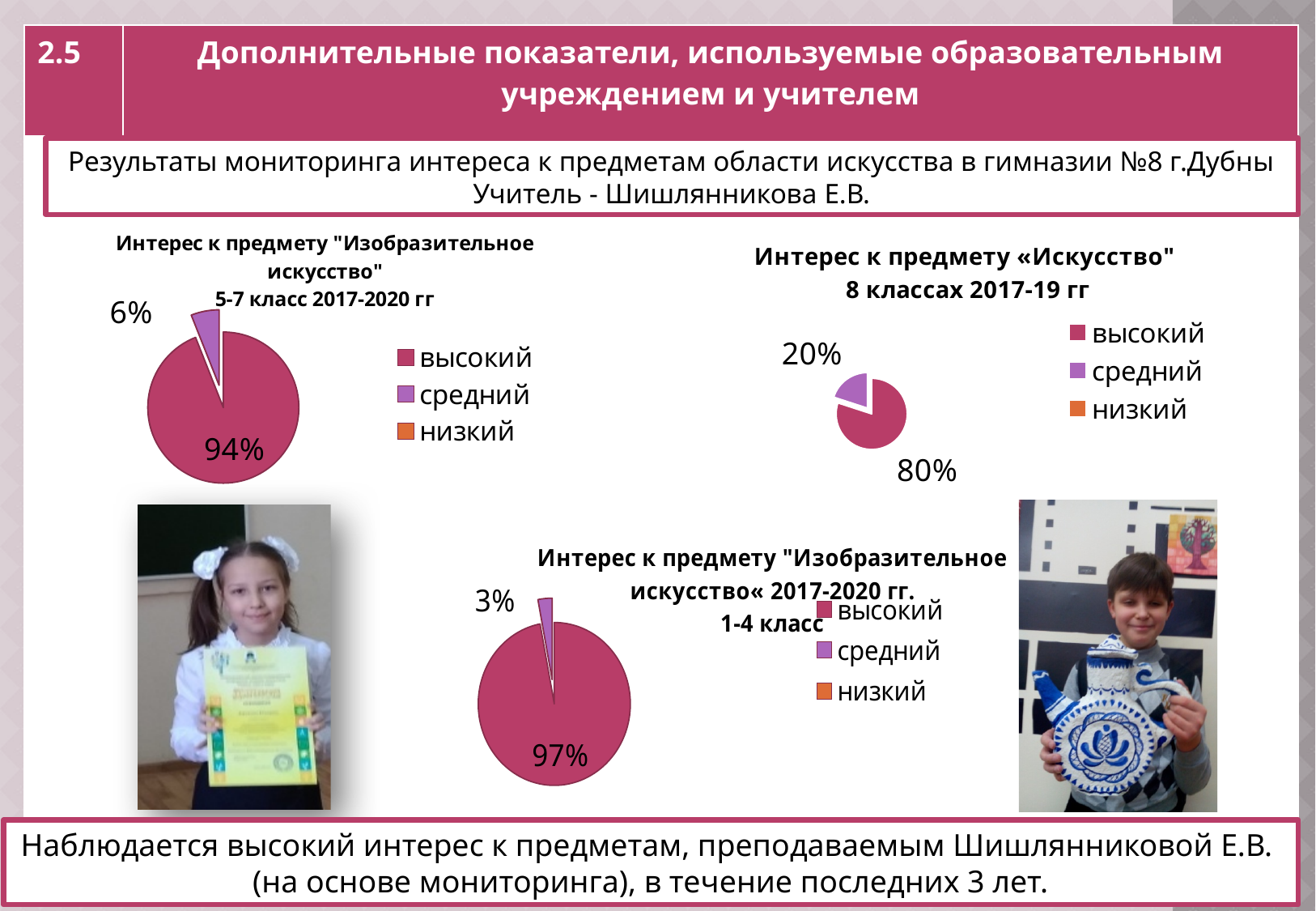
How many slices with data labels are visible in the bottom pie chart (1-4 класс 2017-2020 гг)? 2 In the top-right pie chart (8 классах 2017-19 гг), which category has the largest slice? высокий In the top-right pie chart (8 классах 2017-19 гг), what share is labelled for "средний"? 20% In the top-left pie chart (5-7 класс 2017-2020 гг), what share is labelled for "средний"? 6% How many entries does the legend of the top-right pie chart (8 классах 2017-19 гг) list? 3 In the top-left pie chart (5-7 класс 2017-2020 гг), by how many percentage points does "высокий" exceed "средний"? 88 Which is larger: the "высокий" share in the bottom pie chart (1-4 класс) or the "высокий" share in the top-right pie chart (8 классах)? the bottom pie chart (1-4 класс), 97% In the bottom pie chart (1-4 класс 2017-2020 гг), what share is labelled for "высокий"? 97% In the top-left pie chart (5-7 класс 2017-2020 гг), what share is labelled for "высокий"? 94% In the top-right pie chart (Интерес к предмету «Искусство» 8 классах 2017-19 гг), what share is labelled for "высокий"? 80% What type of chart is used for "Интерес к предмету «Искусство» 8 классах 2017-19 гг"? pie chart In the bottom pie chart (1-4 класс 2017-2020 гг), what share is labelled for "средний"? 3%